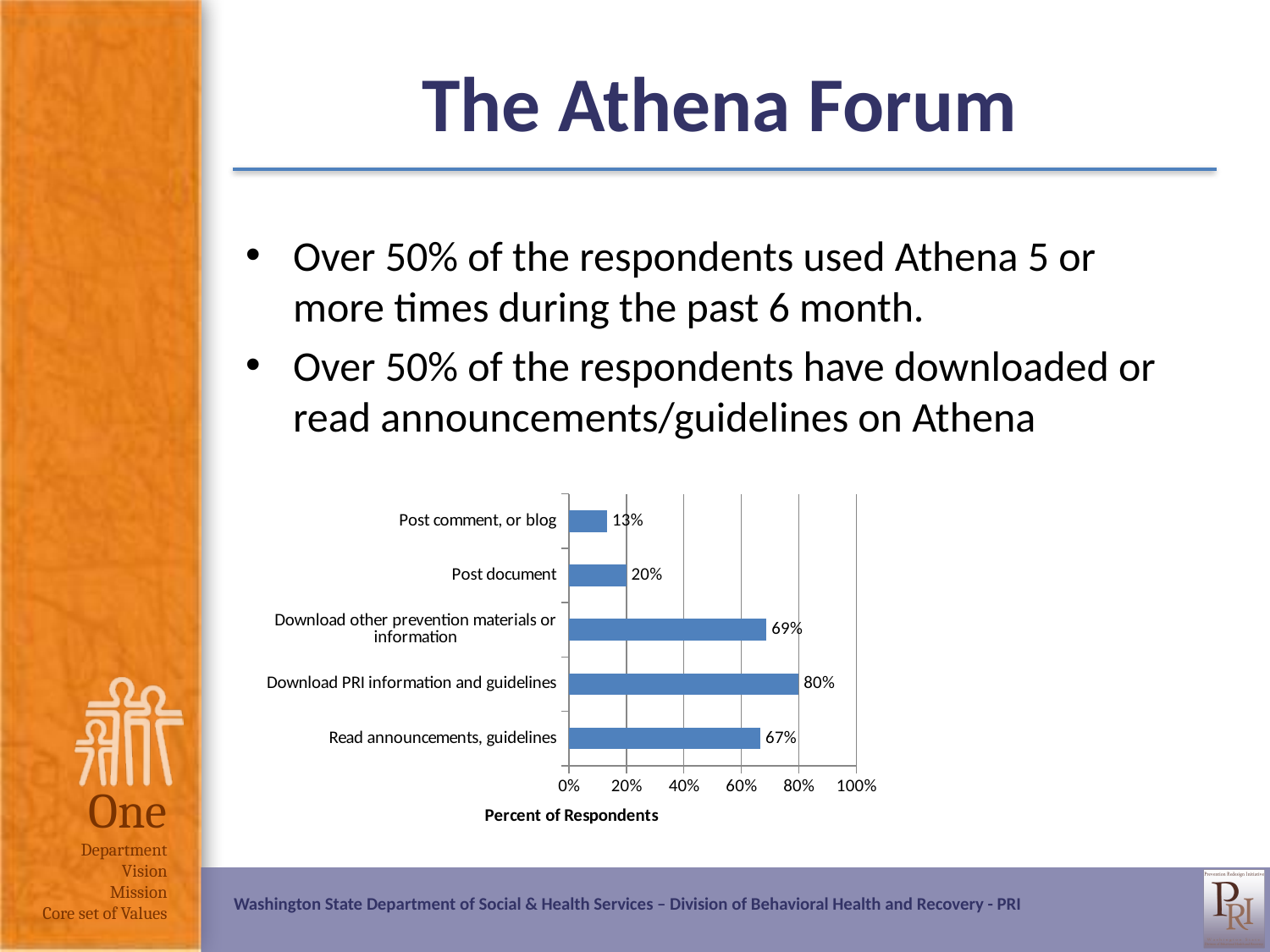
Which is larger: 'Read announcements, guidelines' or 'Download other prevention materials or information'? Download other prevention materials or information What is the difference between 'Download PRI information and guidelines' and 'Post document'? 60% What type of chart is shown on the slide? Bar chart What percentage of respondents reported 'Download PRI information and guidelines'? 80% Which category has the lowest percentage of respondents? Post comment, or blog What is the label of the horizontal axis of the chart? Percent of Respondents What is the value for 'Download other prevention materials or information'? 69% What percentage of respondents reported 'Read announcements, guidelines'? 67% Which category has the highest percentage of respondents? Download PRI information and guidelines Is the value for 'Post document' greater or less than 40%? less What is the value for 'Post comment, or blog'? 13% How many categories are shown in the chart? 5